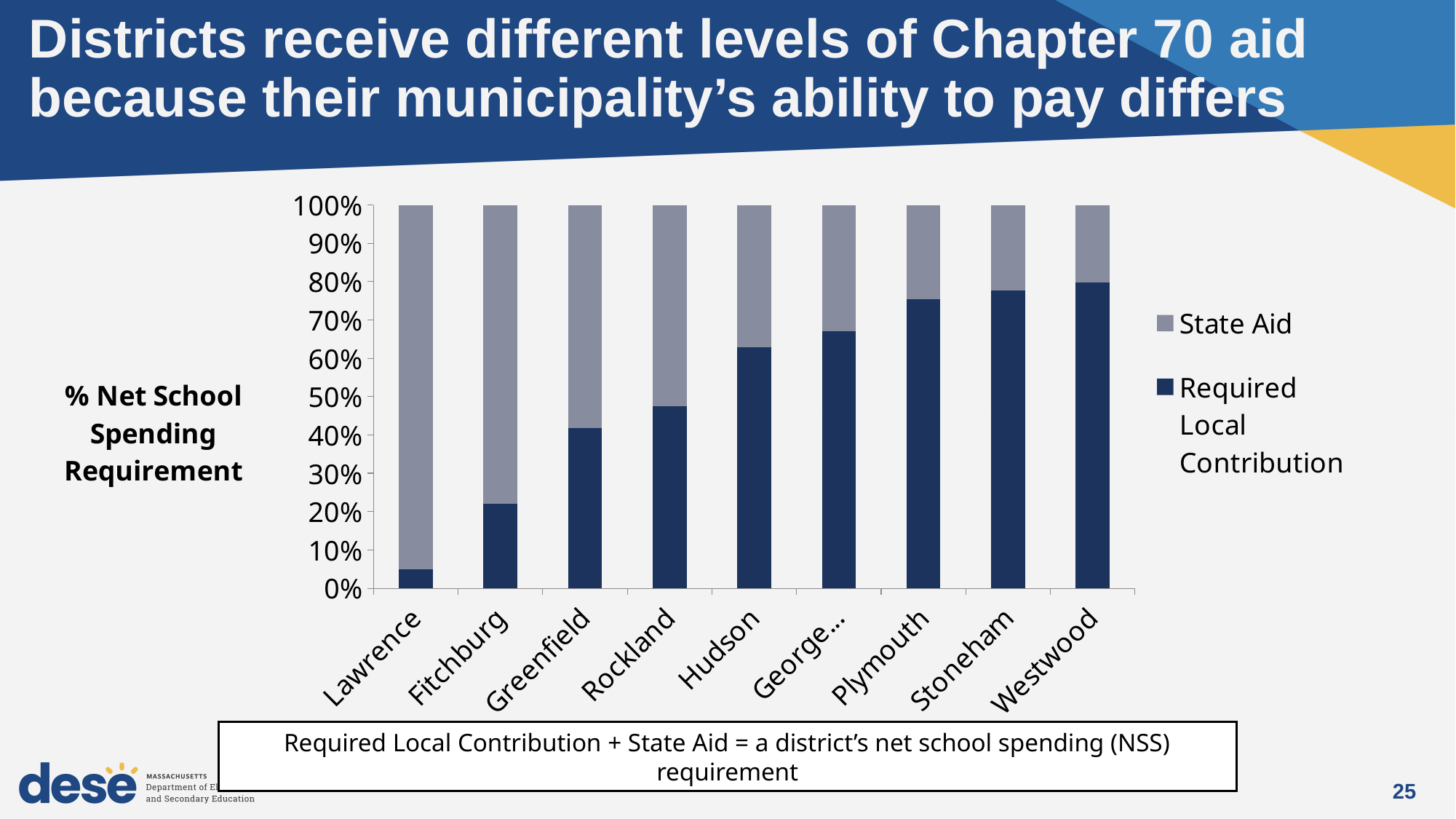
What kind of chart is shown on the slide? Stacked bar chart Which district has the lowest Required Local Contribution share? Lawrence Is the Required Local Contribution for Hudson greater or less than 60%? greater How many series does the chart's legend list? 2 Is the Required Local Contribution for Lawrence greater or less than 10%? less How many districts are shown on the x axis of the chart? 9 Which is larger, the Required Local Contribution for Fitchburg or for Plymouth? Plymouth Does the Required Local Contribution share rise or fall moving from Lawrence to Westwood along the x axis? Rise Which district has the highest State Aid share? Lawrence Is the Required Local Contribution for Rockland greater or less than 50%? less What label is shown for the chart's vertical axis? % Net School Spending Requirement